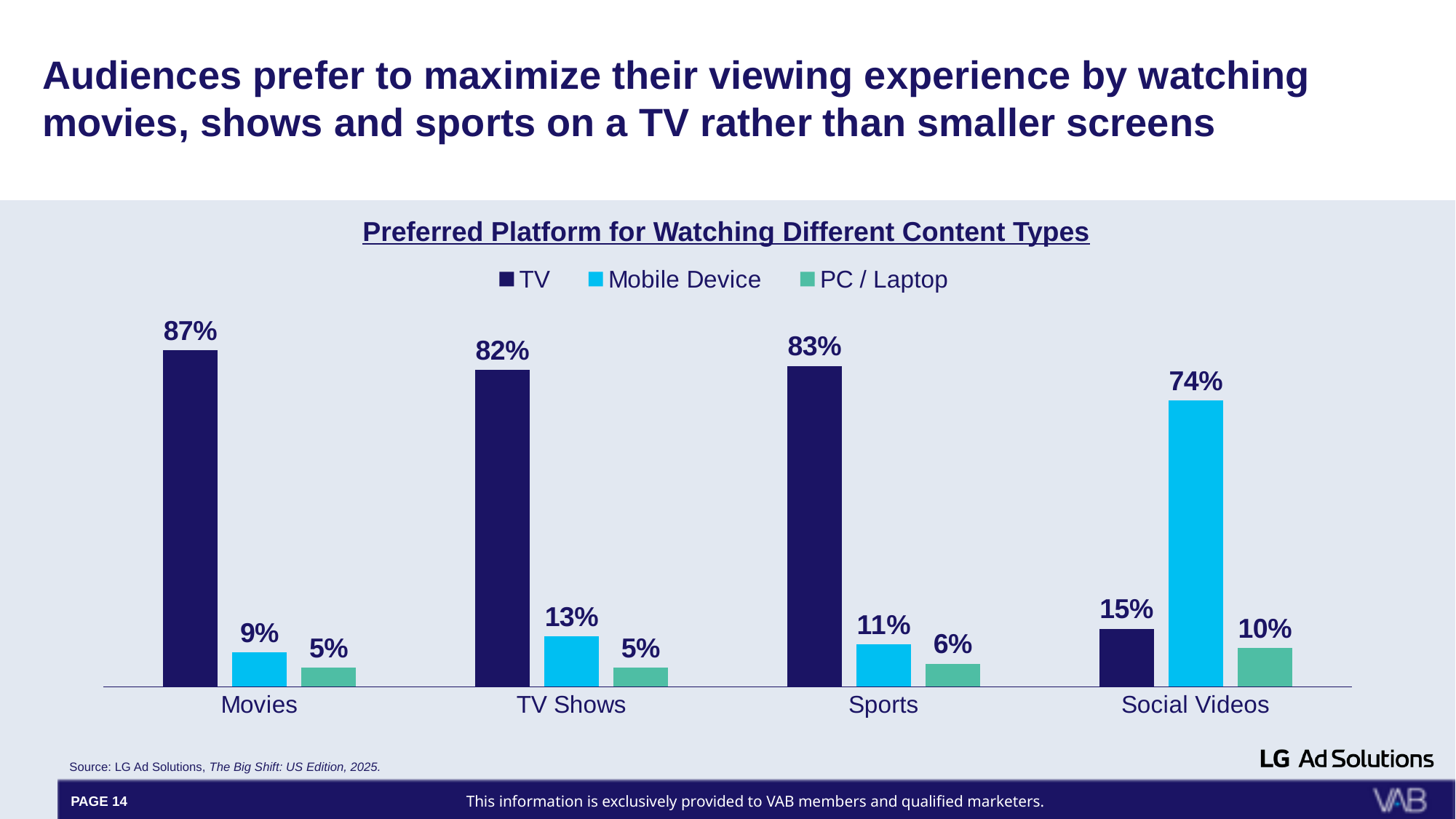
What is the PC / Laptop value for Sports? 6% What percentage prefer TV for watching Movies? 87% What kind of chart is shown? Bar chart Which series is shown in the dark navy colour? TV Which is larger for Sports: the Mobile Device value or the PC / Laptop value? Mobile Device Which content type has the highest TV value? Movies How many series does the legend list? 3 What is the title of the chart? Preferred Platform for Watching Different Content Types How many content types are shown on the x axis? 4 What is the difference between the TV value and the Mobile Device value for TV Shows? 69% What is the Mobile Device value for Social Videos? 74% Which content type has the lowest TV value? Social Videos